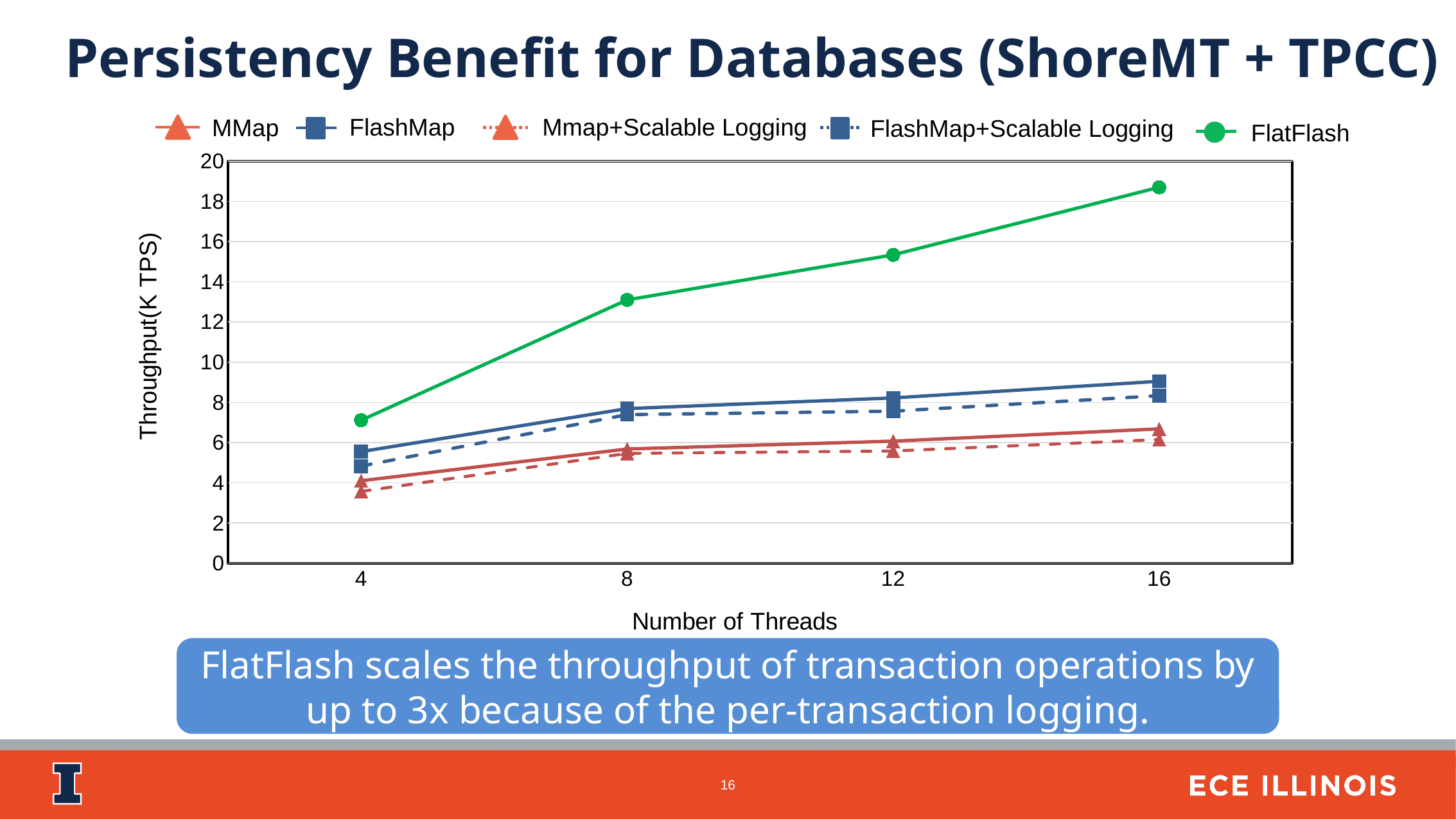
Is the FlatFlash throughput at 16 threads greater or less than 16? greater What is the label of the y axis? Throughput(K TPS) What kind of chart is shown on the slide? line chart Is the MMap throughput at 4 threads greater or less than 6? less Which series has the highest throughput at 16 threads? FlatFlash Which is larger: the FlatFlash throughput at 8 threads or the FlashMap throughput at 16 threads? FlatFlash at 8 threads Is the FlatFlash throughput at 4 threads greater or less than 8? less Does the FlatFlash throughput rise or fall as the number of threads increases? rise Which series has the lowest throughput at 4 threads? Mmap+Scalable Logging How many series does the legend list? 5 How many thread counts are plotted along the x axis? 4